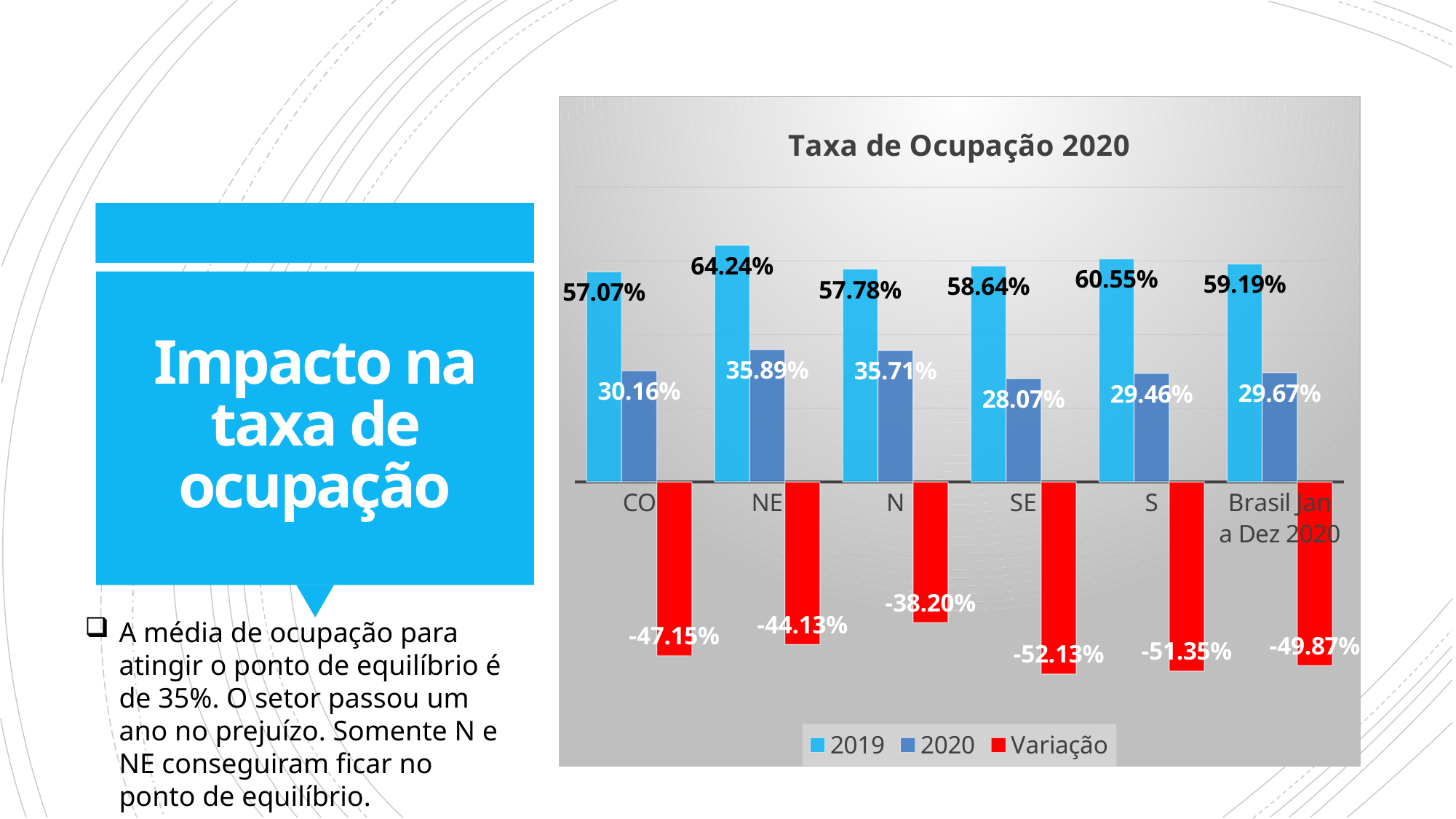
Which category has the lowest (most negative) Variação value? SE What kind of chart is shown on the slide? Bar chart What is the 2019 value for NE? 64.24% What is the 2020 value for SE? 28.07% What is the difference between the 2019 values for NE and CO? 7.17% Which is larger, the 2020 value for N or the 2020 value for S? N What is the 2020 value for Brasil Jan a Dez 2020? 29.67% Which category has the lowest 2020 value? SE How many categories are shown on the x axis? 6 What is the Variação value for N? -38.20% Which category has the highest 2019 value? NE How many series does the legend list? 3